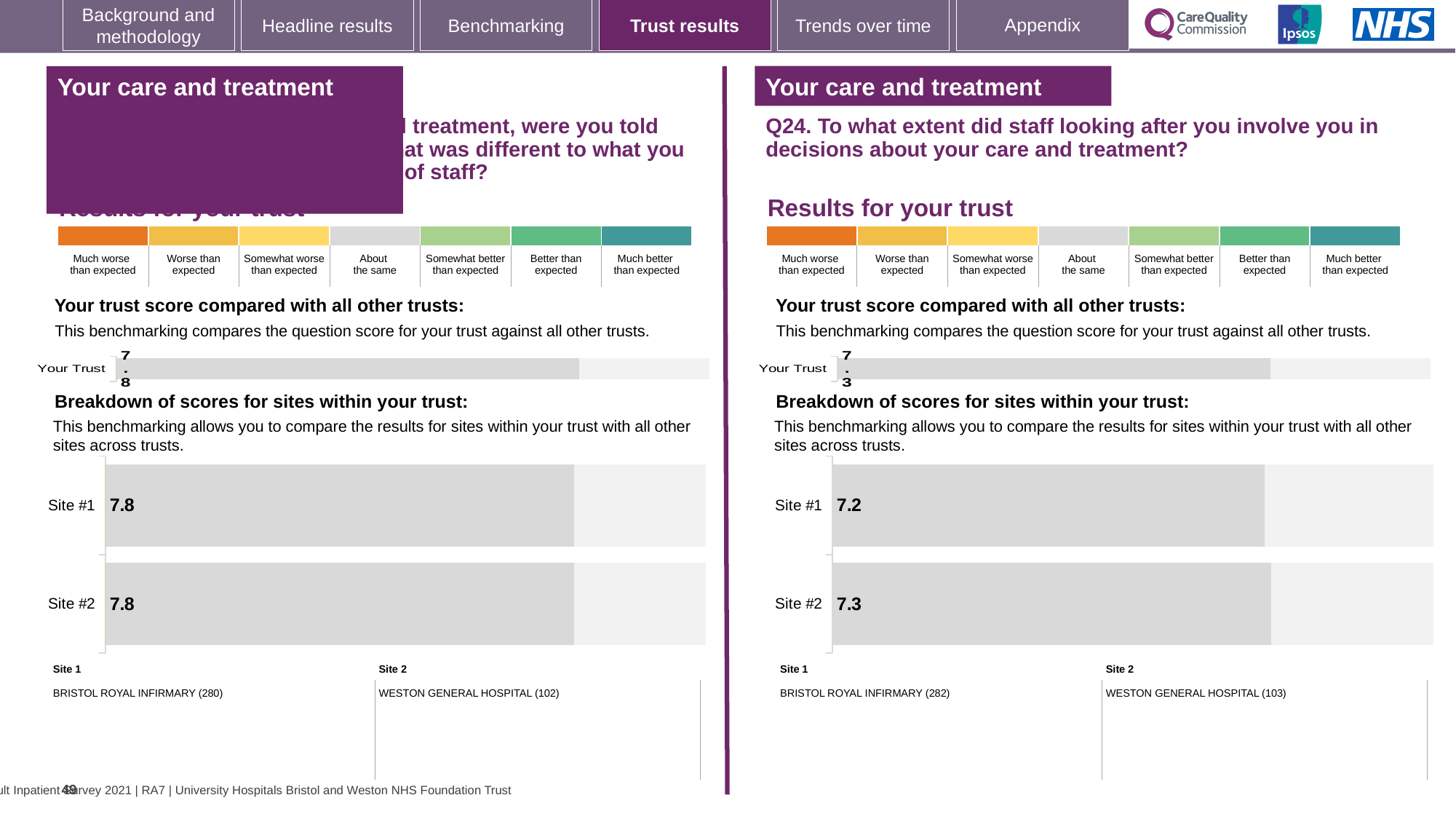
On the left-hand chart, what is the score for Site #2? 7.8 On the right-hand chart (Q24), what is the score for Site #2? 7.3 On the right-hand chart (Q24), what is the difference between the Site #2 score and the Site #1 score? 0.1 How many sites are shown in the site breakdown chart on the right-hand side (Q24)? 2 On the right-hand chart (Q24), which hospital is listed as Site 2? WESTON GENERAL HOSPITAL (103) On the left-hand chart, which hospital is listed as Site 1? BRISTOL ROYAL INFIRMARY (280) What type of chart is used to show the breakdown of scores for sites on the right-hand side (Q24)? Bar chart On the right-hand chart (Q24), what is the score for Site #1? 7.2 On the left-hand chart, what is the score for Site #1? 7.8 On the left-hand chart, what is the score shown for Your Trust? 7.8 On the right-hand chart (Q24), which site has the higher score, Site #1 or Site #2? Site #2 On the right-hand chart (Q24), what is the score shown for Your Trust? 7.3